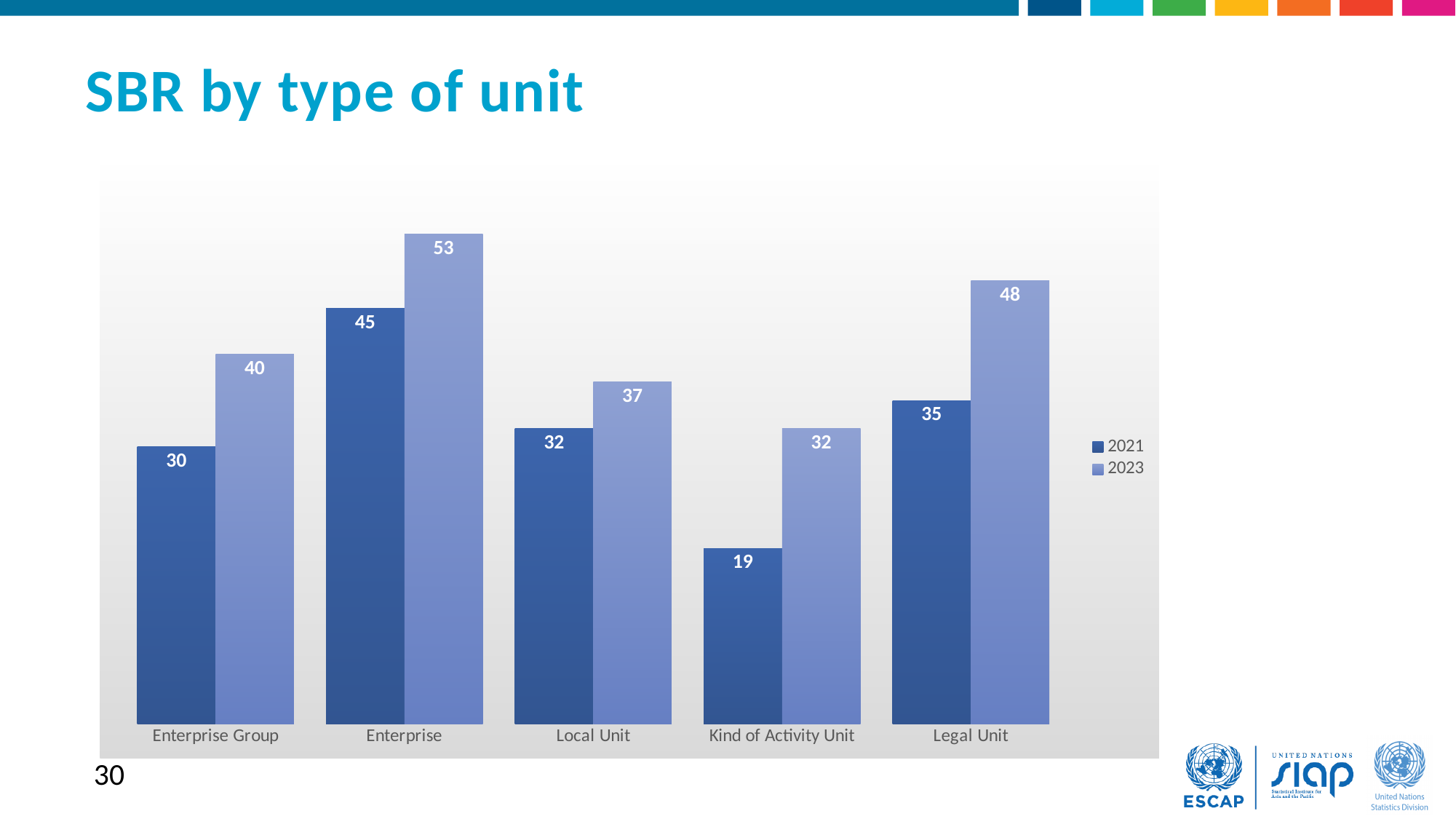
What is the value for Enterprise in 2023? 53 What is the value for Kind of Activity Unit in 2021? 19 What kind of chart is shown on the slide? Bar chart How many series does the legend list? 2 How many types of unit are shown on the x axis? 5 Which type of unit has the lowest value in 2021? Kind of Activity Unit What is the value for Legal Unit in 2023? 48 What is the difference between the 2023 values for Enterprise and Local Unit? 16 What is the value for Enterprise Group in 2021? 30 What is the difference between the 2023 and 2021 values for Kind of Activity Unit? 13 Which is larger: the 2021 value for Legal Unit or the 2021 value for Local Unit? Legal Unit Which type of unit has the highest value in 2023? Enterprise